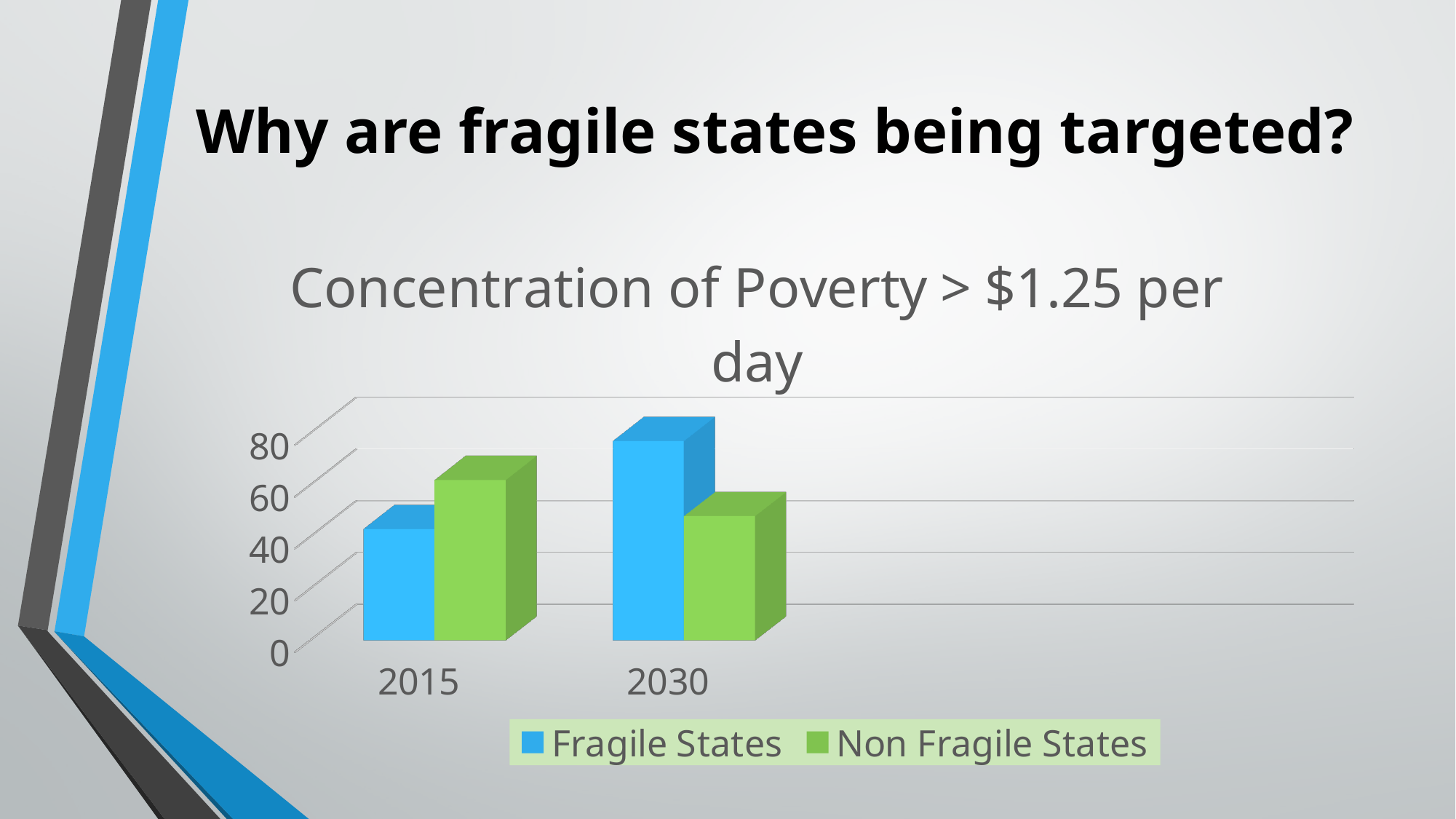
In 2015, which is larger: Fragile States or Non Fragile States? Non Fragile States In 2030, which is larger: Fragile States or Non Fragile States? Fragile States Which series is shown in blue? Fragile States How many year categories are shown on the x axis? 2 Is the value for Non Fragile States in 2015 greater or less than 40? greater What is the title of the chart? Concentration of Poverty > $1.25 per day Is the value for Fragile States in 2030 greater or less than 60? greater Does the value for Fragile States rise or fall from 2015 to 2030? rise How many series does the legend list? 2 What kind of chart is shown on the slide? bar chart Is the value for Non Fragile States in 2030 greater or less than 60? less